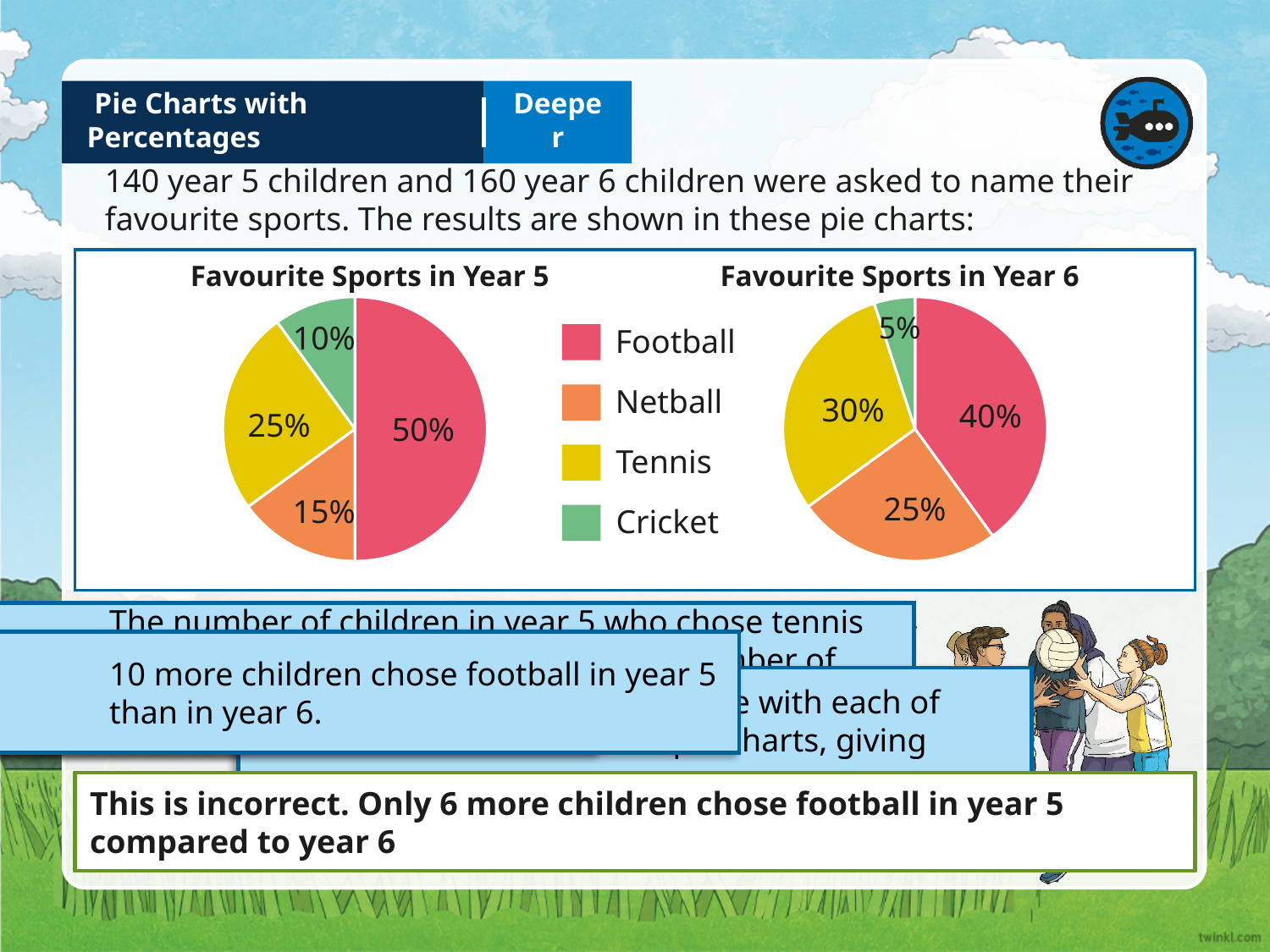
In the 'Favourite Sports in Year 5' pie chart, what percentage of children chose Football? 50% Which is larger: the Netball share in the 'Favourite Sports in Year 5' chart or the Netball share in the 'Favourite Sports in Year 6' chart? Year 6 In the 'Favourite Sports in Year 6' pie chart, what percentage of children chose Cricket? 5% How many sports are shown in the 'Favourite Sports in Year 5' pie chart? 4 In the 'Favourite Sports in Year 5' pie chart, what percentage of children chose Netball? 15% What is the difference between the Football percentage in the Year 5 pie chart and the Football percentage in the Year 6 pie chart? 10% What type of chart is used to show the favourite sports in Year 5 and Year 6? Pie chart In the 'Favourite Sports in Year 5' pie chart, which sport has the smallest share? Cricket Which colour represents Tennis in the legend shared by the two pie charts? Yellow In the 'Favourite Sports in Year 6' pie chart, which sport has the largest share? Football In the 'Favourite Sports in Year 6' pie chart, what percentage of children chose Tennis? 30% In the 'Favourite Sports in Year 6' pie chart, what is the combined share of Tennis and Cricket? 35%